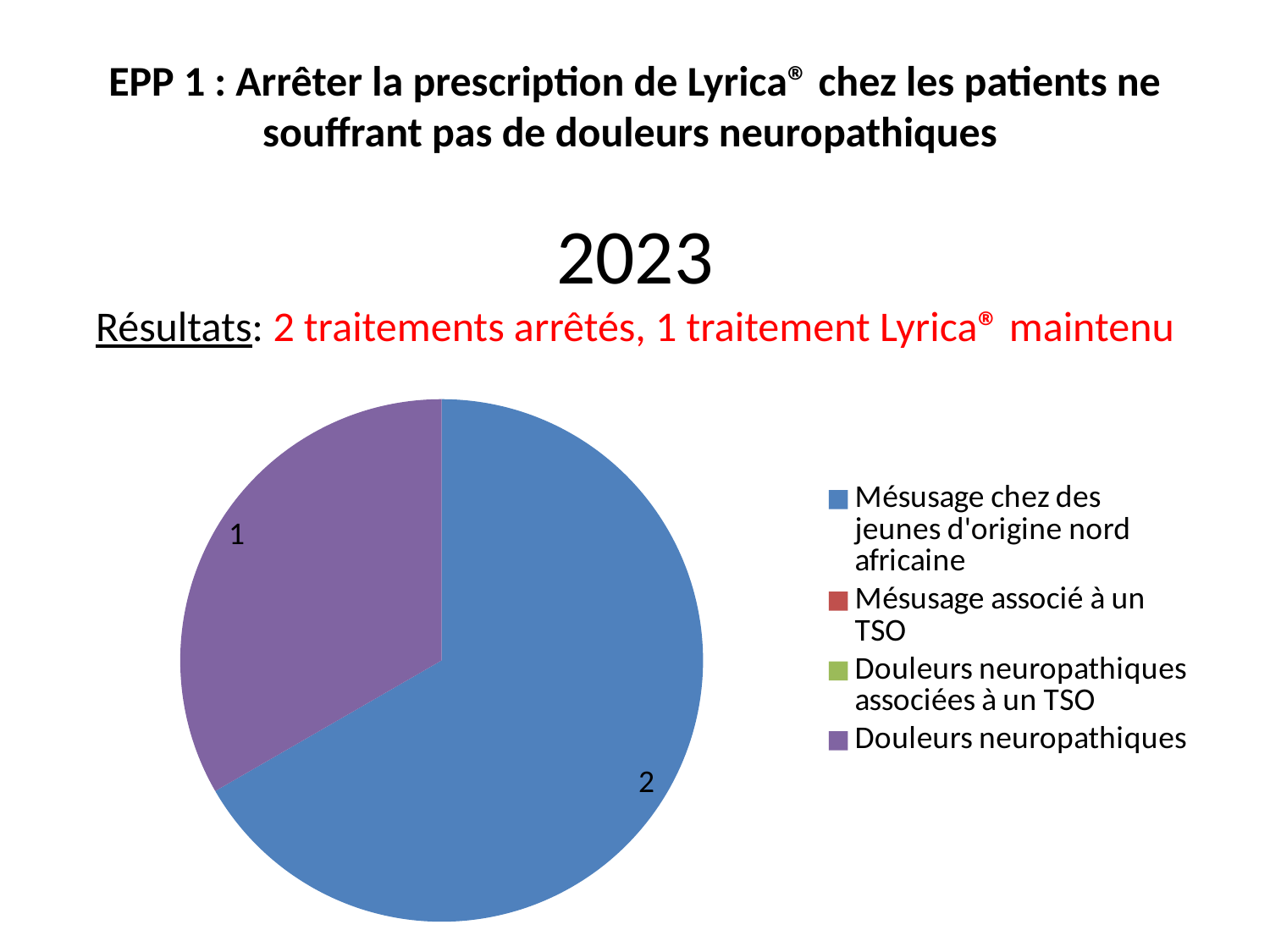
How many entries does the legend of the pie chart list? 4 How many slices with data labels are visible in the pie chart? 2 What colour is the slice for "Douleurs neuropathiques"? purple Which is larger: the slice for "Mésusage chez des jeunes d'origine nord africaine" or the slice for "Douleurs neuropathiques"? Mésusage chez des jeunes d'origine nord africaine What year is shown above the pie chart? 2023 What is the value of the slice for "Mésusage chez des jeunes d'origine nord africaine"? 2 Which category has the largest slice in the pie chart? Mésusage chez des jeunes d'origine nord africaine Which of the visible slices is the smallest? Douleurs neuropathiques What is the value of the slice for "Douleurs neuropathiques"? 1 What is the total of the values shown on the pie chart? 3 What type of chart is shown on the slide? pie chart What is the difference between the value for "Mésusage chez des jeunes d'origine nord africaine" and the value for "Douleurs neuropathiques"? 1